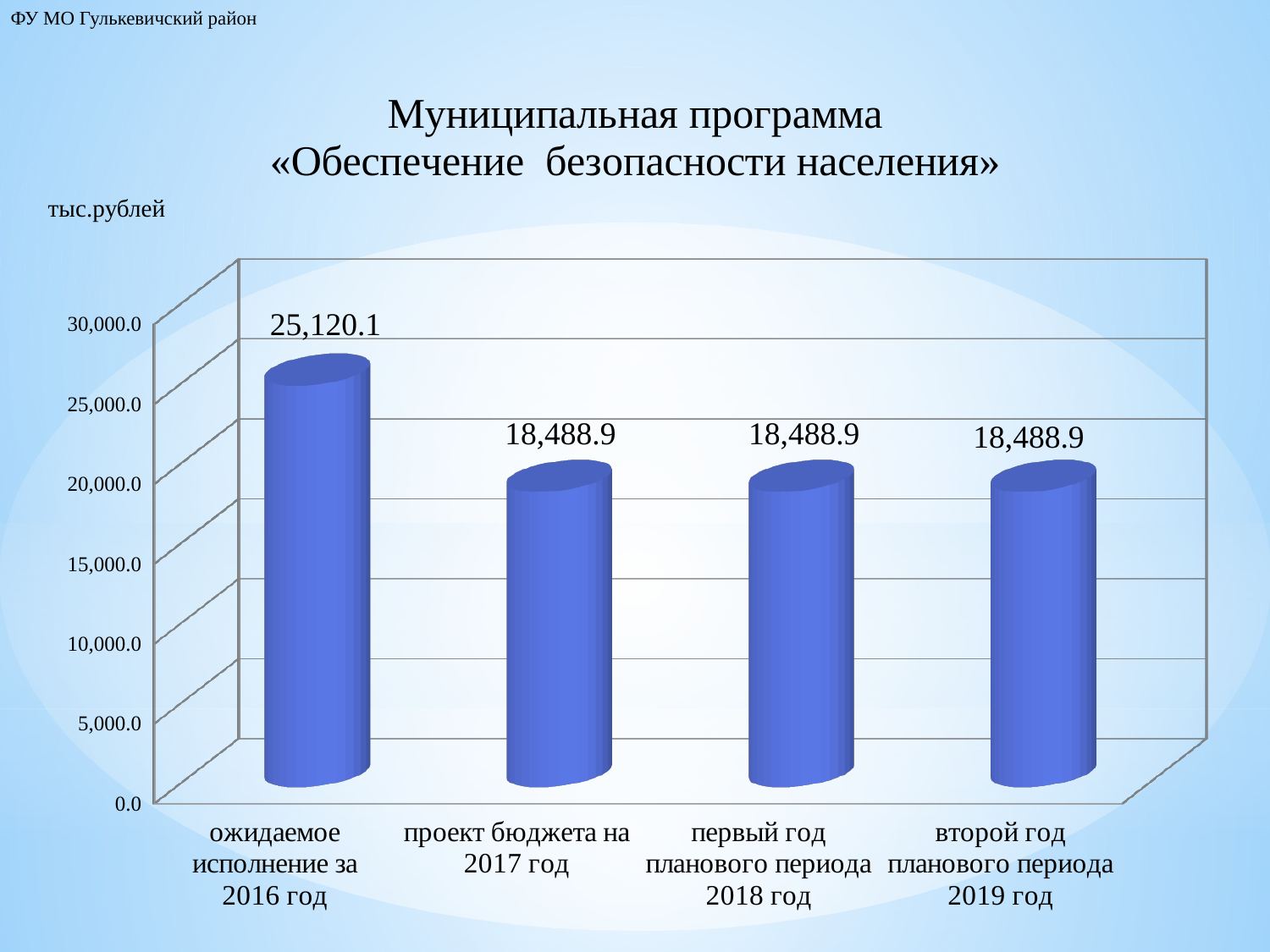
How many categories are shown on the chart? 4 Which is larger: the value for ожидаемое исполнение за 2016 год or the value for первый год планового периода 2018 год? ожидаемое исполнение за 2016 год What is the difference between the value for 2016 год and the value for 2017 год? 6,631.2 What is the value for второй год планового периода 2019 год? 18,488.9 What is the value for проект бюджета на 2017 год? 18,488.9 What is the value for ожидаемое исполнение за 2016 год? 25,120.1 What kind of chart is shown on the slide? bar chart What unit is indicated above the chart? тыс.рублей Is the value for проект бюджета на 2017 год greater or less than 20,000.0? less Is the value for ожидаемое исполнение за 2016 год greater or less than 25,000.0? greater Which category has the highest value? ожидаемое исполнение за 2016 год Do the values rise or fall from the 2016 category to the 2017 category? fall